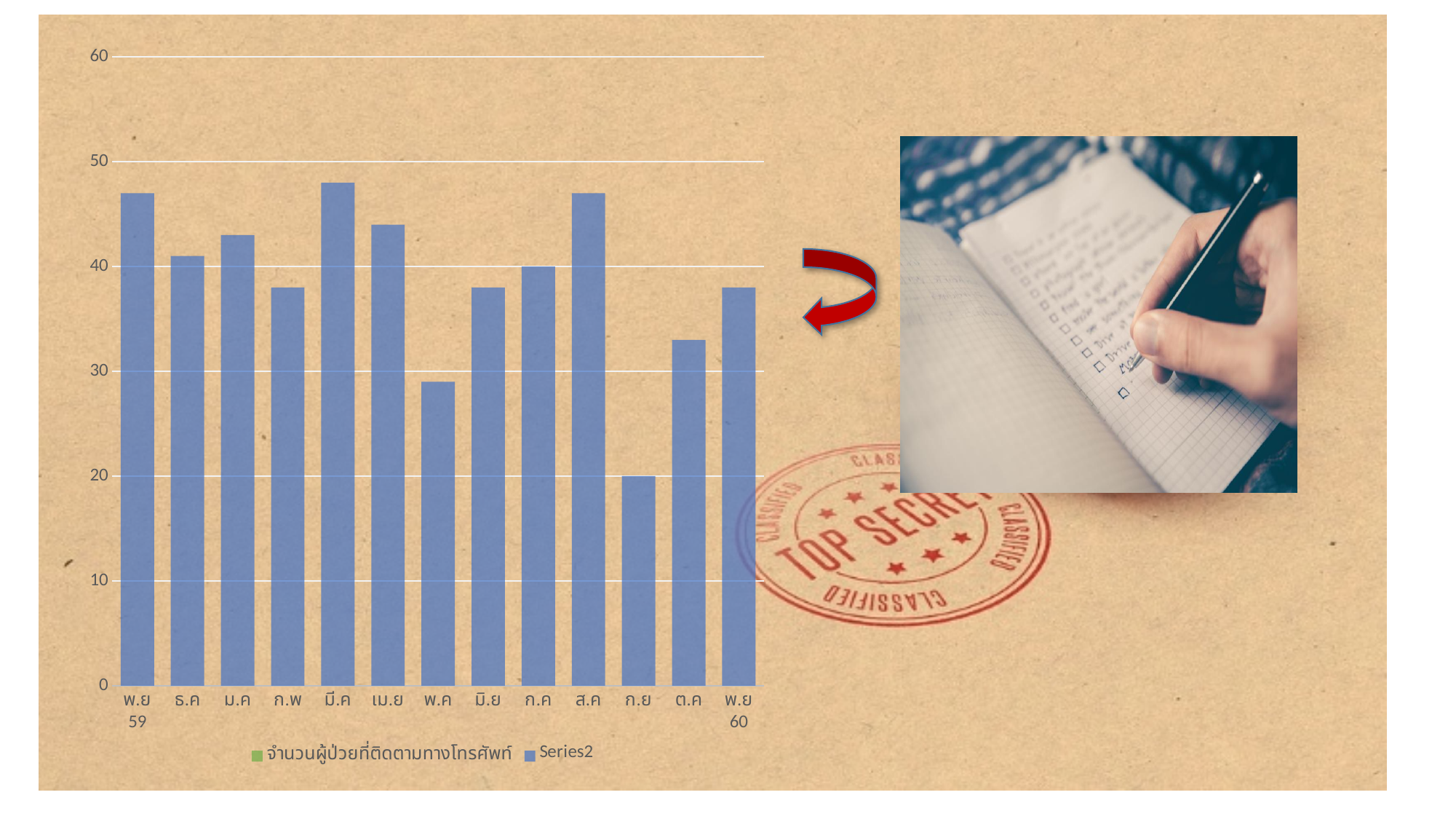
Is the value for ต.ค greater or less than 30? greater Is the value for มี.ค greater or less than 40? greater What colour are the bars in the chart? blue What is the name of the second series listed in the chart's legend? Series2 What kind of chart is shown on the slide? bar chart Which is larger, the value for มี.ค or the value for ก.ย? มี.ค How many series does the chart's legend list? 2 Is the value for ก.พ greater or less than 40? less Which month has the lowest bar in the chart? ก.ย Which is larger, the value for พ.ค or the value for ส.ค? ส.ค How many categories (months) are shown on the x axis of the chart? 13